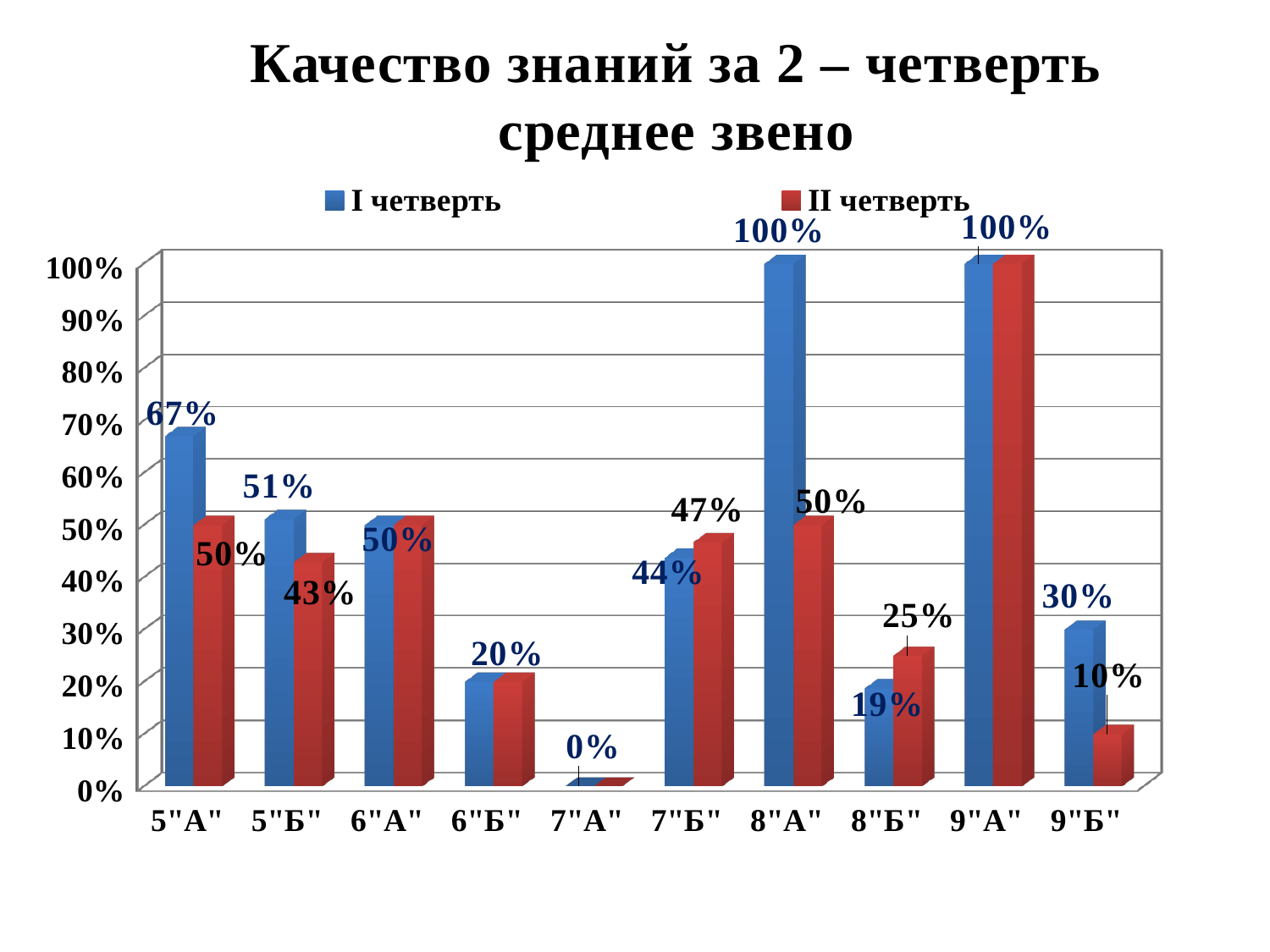
What is the value for 5"Б" in the II четверть series? 43% What is the value for 9"Б" in the I четверть series? 30% What is the difference between the I четверть and II четверть values for 5"А"? 17% Is the II четверть value for 9"Б" greater or less than 20%? less For 7"Б", which series has the larger value, I четверть or II четверть? II четверть What is the difference between the I четверть and II четверть values for 9"Б"? 20% What is the value for 8"А" in the II четверть series? 50% How many series does the legend list? 2 What kind of chart is shown on the slide? bar chart How many categories are shown on the x axis? 10 Which category has the lowest value in the II четверть series? 7"А" What is the value for 5"А" in the I четверть series? 67%